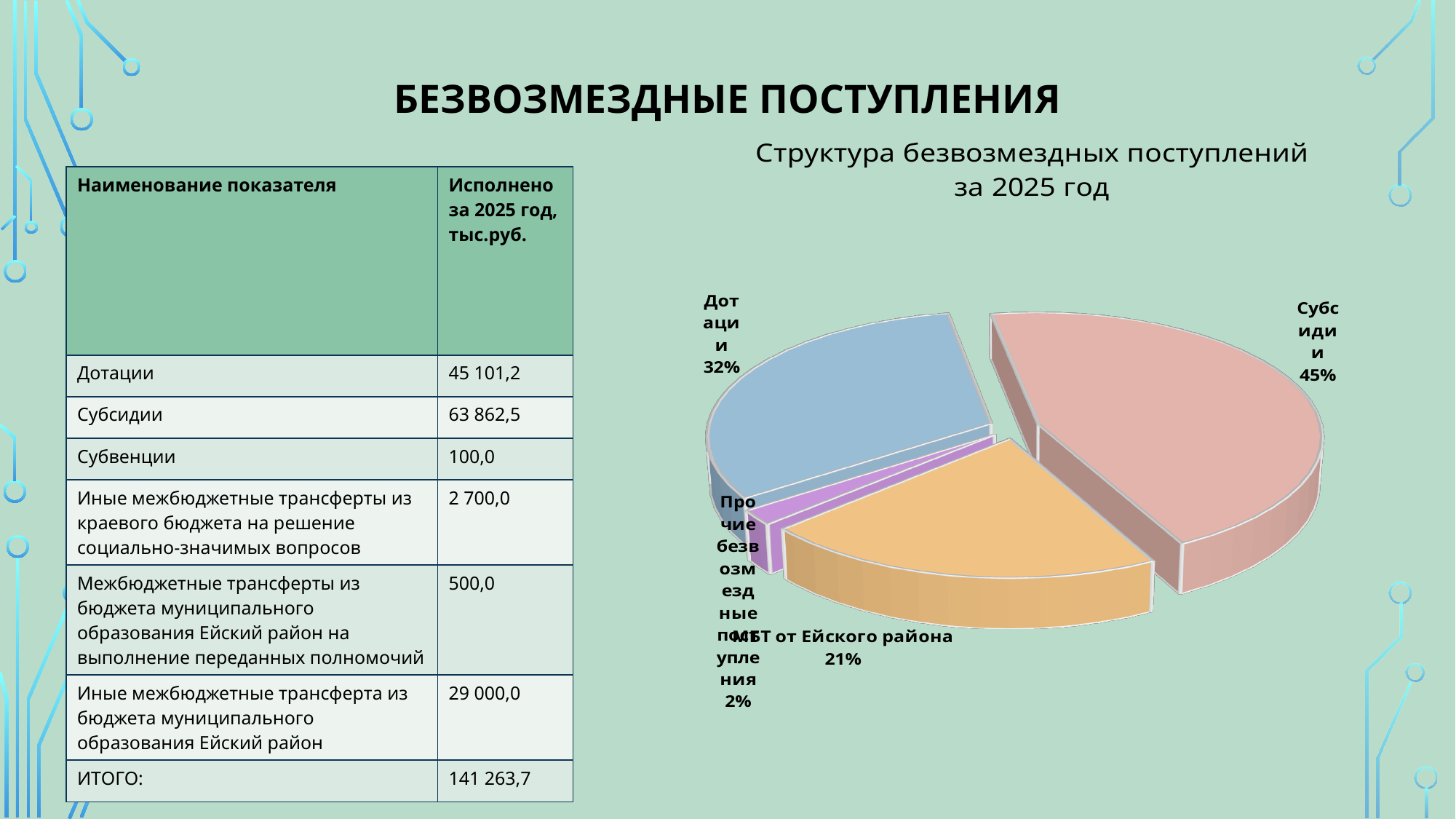
What type of chart is shown on the slide? Pie chart What colour is the Субсидии slice of the pie chart? Pink Which is larger, the Дотации slice or the МБТ от Ейского района slice? Дотации What is the title of the chart? Структура безвозмездных поступлений за 2025 год What share of the pie does Дотации hold? 32% Which slice of the pie chart is the smallest? Прочие безвозмездные поступления What is the difference in percentage points between the Субсидии and Дотации slices? 13 What share of the pie does Субсидии hold? 45% How many slices does the pie chart have? 4 What share of the pie does Прочие безвозмездные поступления hold? 2% What share of the pie does МБТ от Ейского района hold? 21% Which slice of the pie chart is the largest? Субсидии